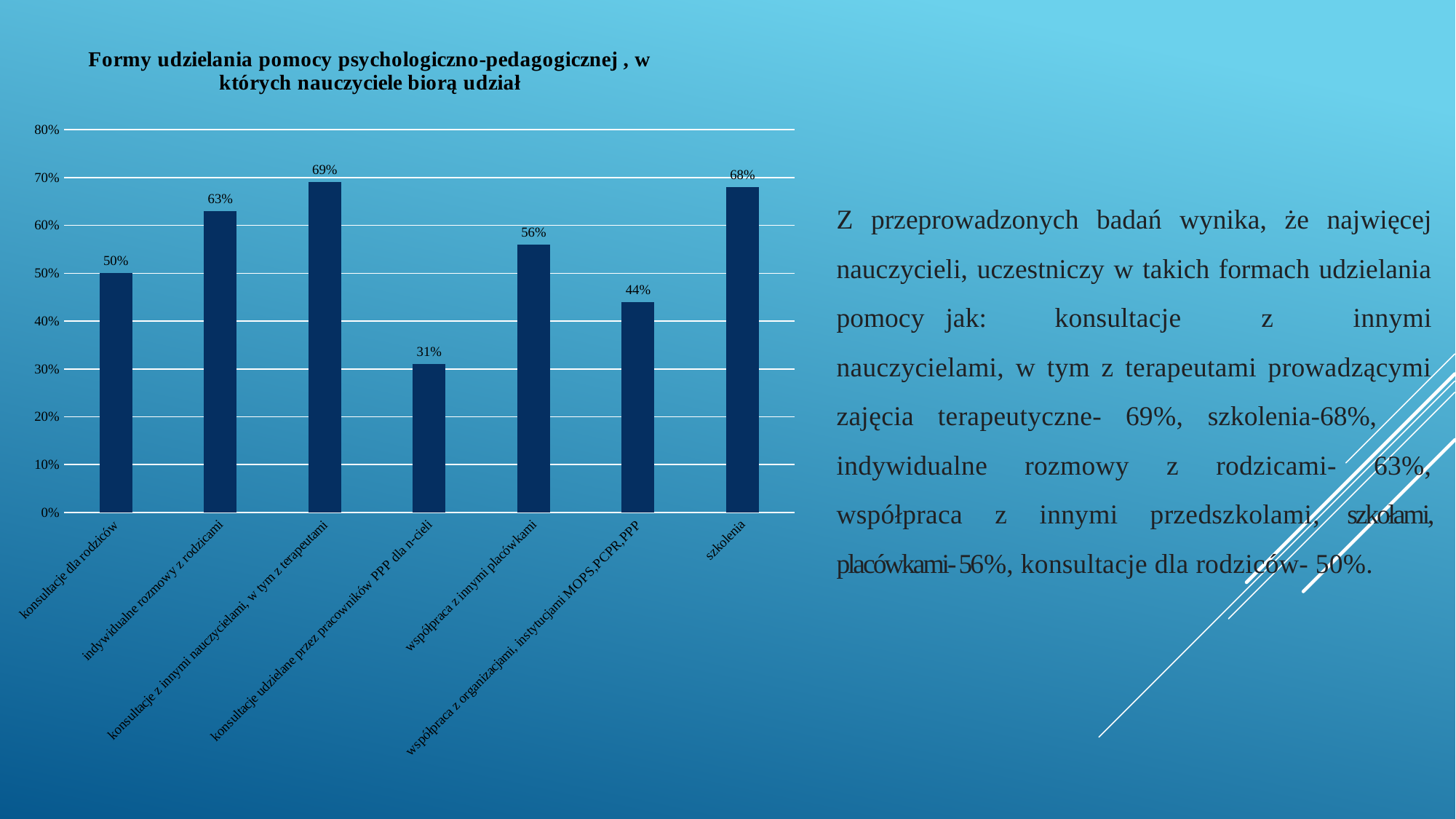
What is the value for 'współpraca z organizacjami, instytucjami MOPS,PCPR,PPP'? 44% What is the difference between the values for 'indywidualne rozmowy z rodzicami' and 'współpraca z innymi placówkami'? 7% Which category has the lowest value? konsultacje udzielane przez pracowników PPP dla n-cieli What is the value shown for 'szkolenia'? 68% Is the value for 'współpraca z innymi placówkami' greater or less than 50%? greater How many categories are shown on the chart? 7 What percentage of teachers take part in 'konsultacje dla rodziców'? 50% What is the value for 'konsultacje udzielane przez pracowników PPP dla n-cieli'? 31% Which is larger: the value for 'szkolenia' or the value for 'indywidualne rozmowy z rodzicami'? szkolenia What kind of chart is shown on the slide? bar chart What is the title of the chart? Formy udzielania pomocy psychologiczno-pedagogicznej , w których nauczyciele biorą udział Which category has the highest value? konsultacje z innymi nauczycielami, w tym z terapeutami